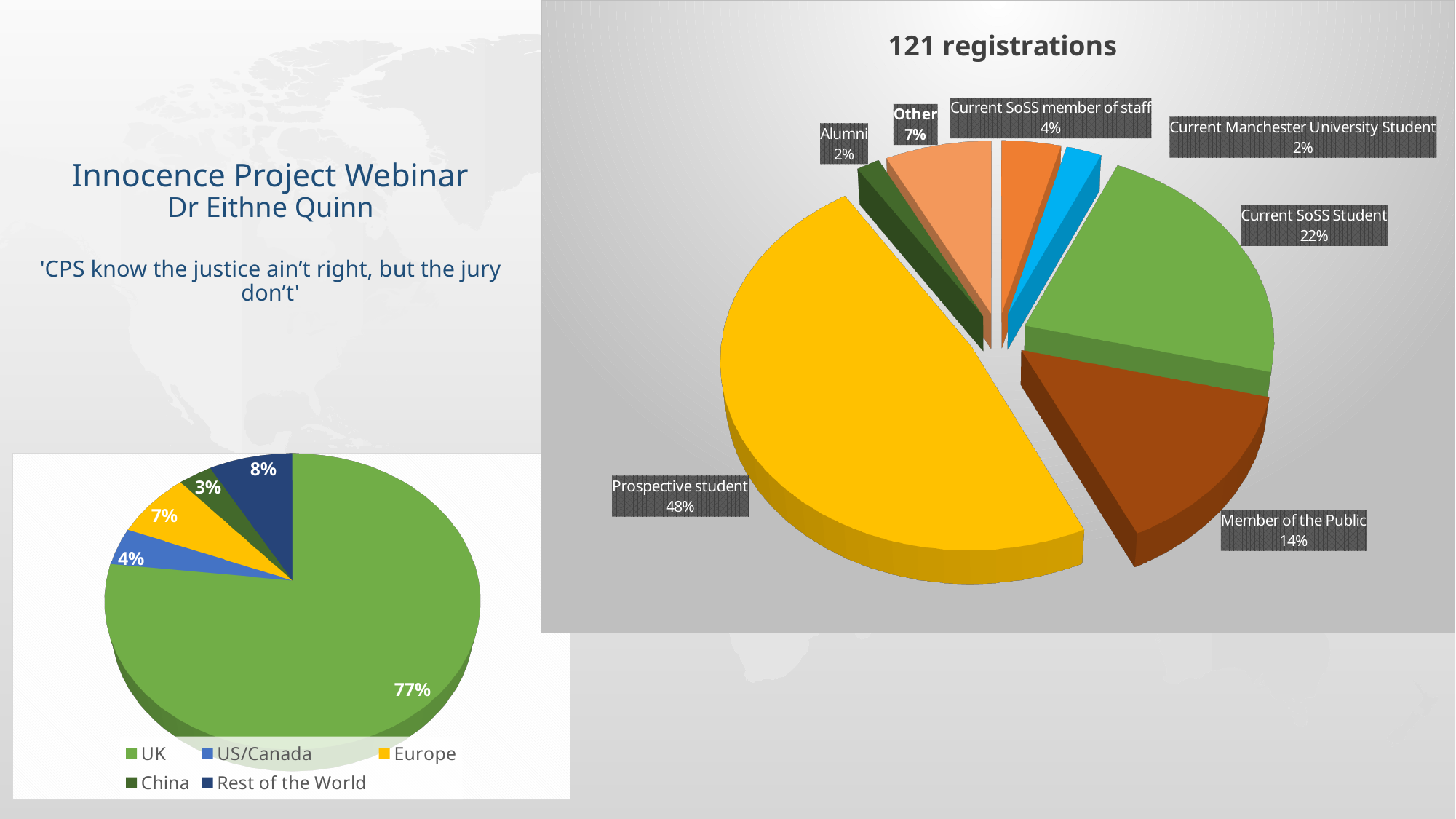
In the bottom-left pie chart, which category has the smallest slice? China In the '121 registrations' chart, what share is labelled for Member of the Public? 14% In the bottom-left pie chart, what share is labelled for UK? 77% How many entries does the legend of the bottom-left pie chart list? 5 In the bottom-left pie chart, what share is labelled for Rest of the World? 8% What kind of chart is the chart in the bottom-left of the slide? Pie chart In the '121 registrations' chart, what is the difference in percentage points between Prospective student and Current SoSS Student? 26 In the '121 registrations' chart, which category has the largest slice? Prospective student In the '121 registrations' chart, how many slices does the pie have? 7 In the '121 registrations' chart, what share is labelled for Prospective student? 48% In the '121 registrations' chart, which is larger: Member of the Public or Other? Member of the Public In the '121 registrations' chart, what share is labelled for Current SoSS Student? 22%